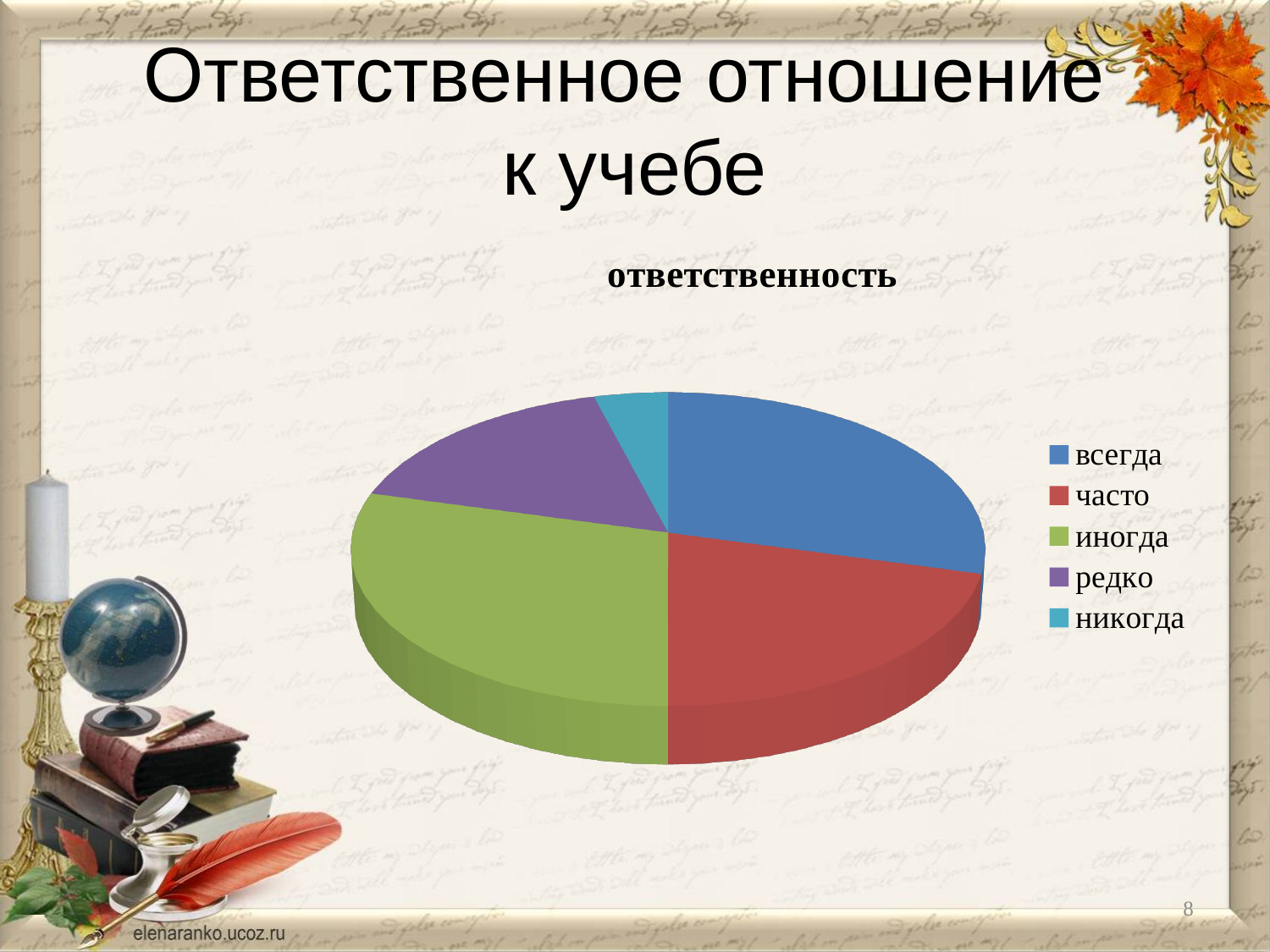
Which colour represents the category никогда in the chart? light blue How many entries does the legend list? 5 Which slice is larger, всегда or редко? всегда Which slice is larger, иногда or никогда? иногда Which category has the smallest slice of the pie? никогда How many categories does the pie chart have? 5 What kind of chart is shown on the slide? pie chart Which slice is larger, редко or никогда? редко What is the title of the chart? ответственность